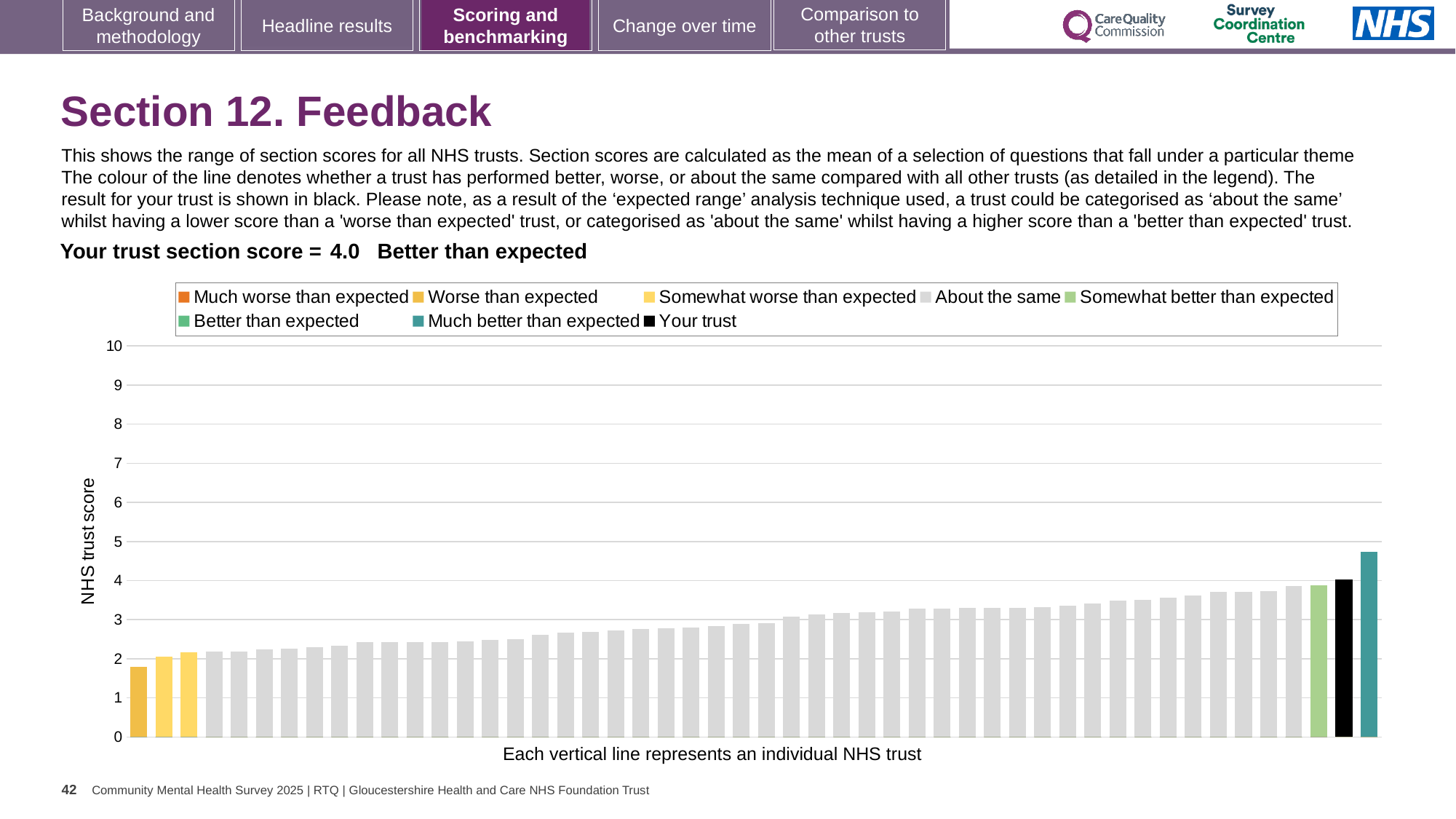
Is the value of the shortest bar (leftmost) greater or less than 2? less What is the section score for your trust shown on the slide? 4.0 Is the value of the tallest bar (teal) greater or less than 4? greater Is the value for your trust (black bar) greater or less than 3? greater Which is larger: the black 'Your trust' bar or the teal bar to its right? The teal bar Do the bar values rise or fall from left to right along the x axis? Rise What kind of chart is shown on the slide? Bar chart According to the legend, what colour represents 'Your trust'? Black What is the label on the vertical axis of the chart? NHS trust score Which legend category does the tallest bar belong to? Much better than expected How many entries does the chart legend list? 8